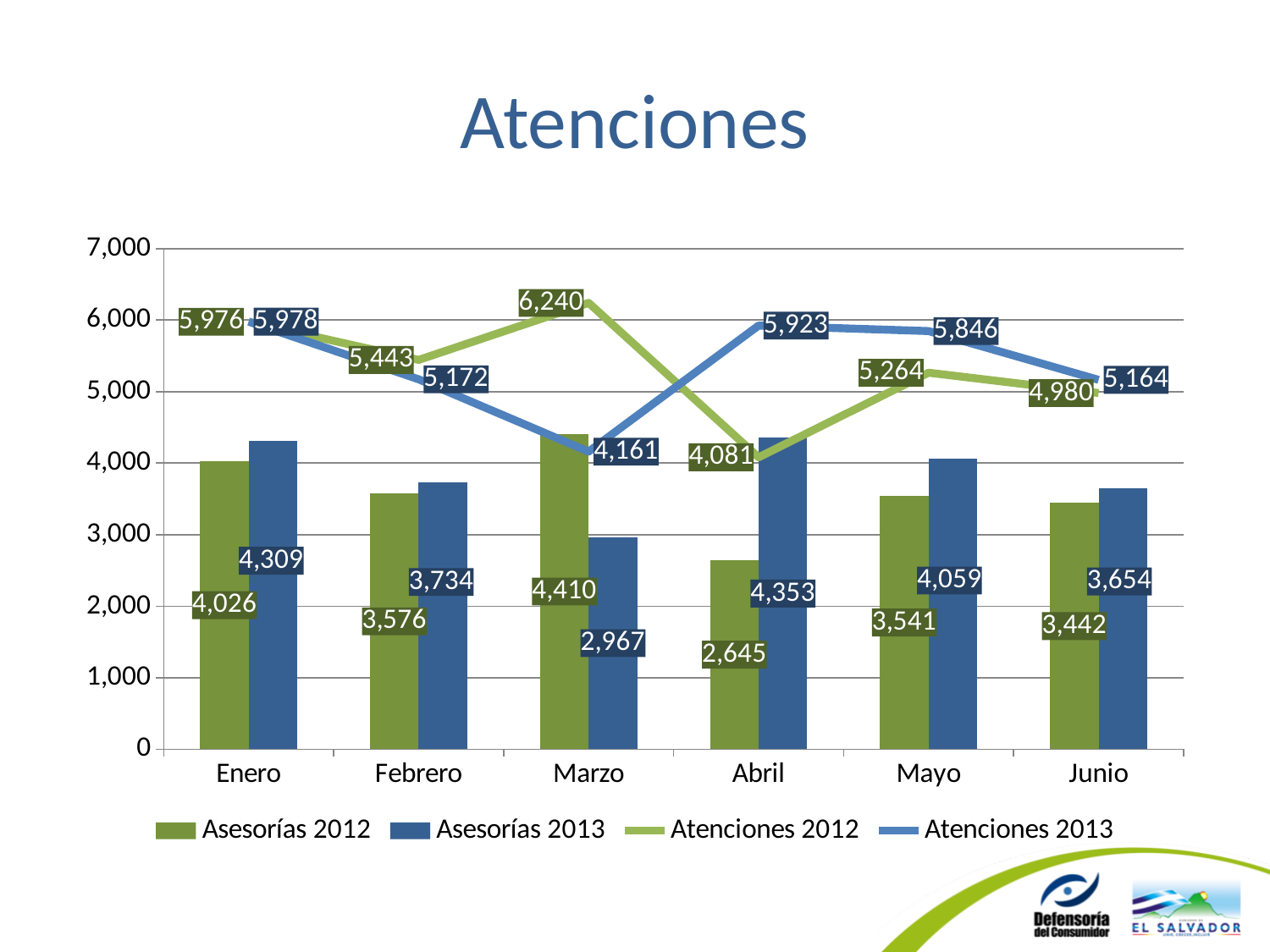
In which month is Atenciones 2012 highest? Marzo What is the value of Atenciones 2012 for Mayo? 5,264 What is the value of Asesorías 2013 for Abril? 4,353 Is the value of Asesorías 2013 for Marzo greater or less than 3,000? less What is the title of the chart? Atenciones What is the value of Atenciones 2013 for Junio? 5,164 How many months are shown on the x axis? 6 What is the difference between Asesorías 2013 and Asesorías 2012 in Enero? 283 In which month is Asesorías 2012 lowest? Abril What is the value of Asesorías 2012 for Marzo? 4,410 Which is larger in Marzo, Atenciones 2012 or Atenciones 2013? Atenciones 2012 How many series does the legend list? 4